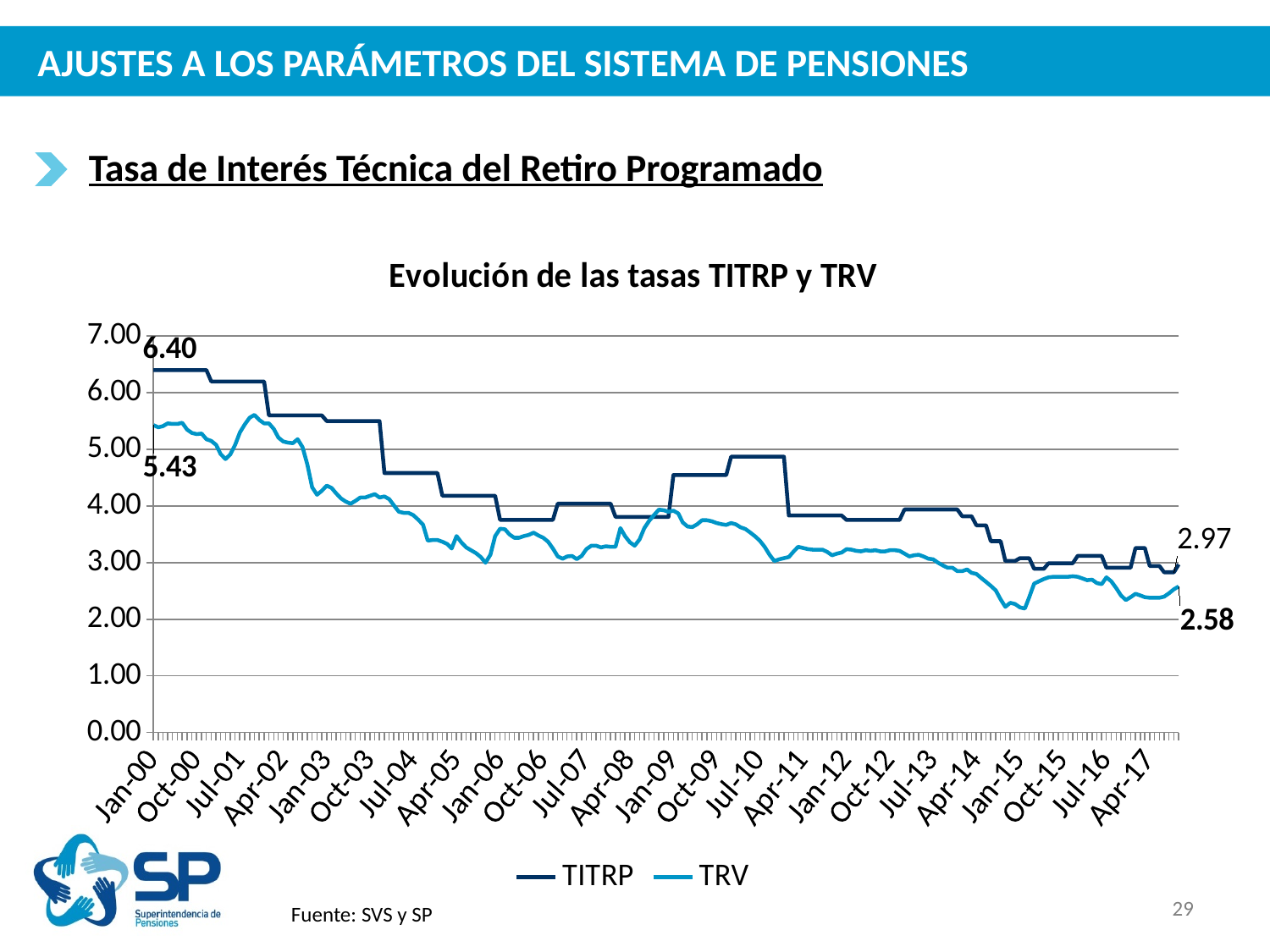
What is the value of TRV at the start of the series (Jan-00)? 5.43 What is the value of TITRP at the start of the series (Jan-00)? 6.40 At the end of the series, which is higher, TITRP or TRV? TITRP Is the TRV value around Jan-15 greater or less than 3.00? less Do the TITRP and TRV rates generally rise or fall from Jan-00 to Apr-17? fall What is the difference between the final labelled values of TITRP (2.97) and TRV (2.58)? 0.39 By how much did TITRP fall from its starting value of 6.40 to its final value of 2.97? 3.43 What is the difference between the TITRP and TRV values at the start of the series (6.40 vs 5.43)? 0.97 How many series does the legend list? 2 Is the TITRP value around Jul-10 greater or less than 4.00? greater What is the final labelled value of the TRV series? 2.58 What is the final labelled value of the TITRP series? 2.97